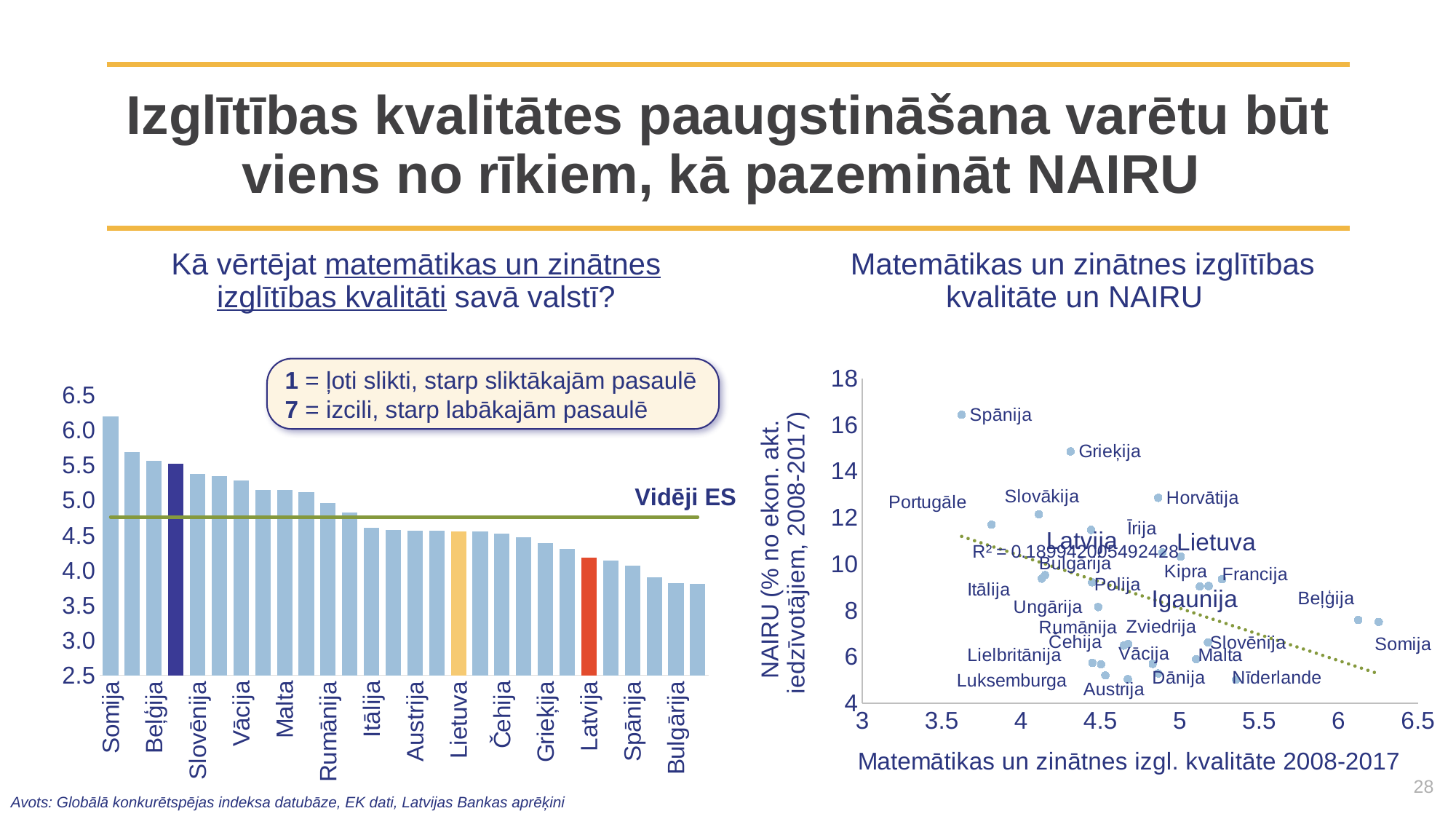
In the left bar chart, is the value for Somija greater or less than 6? greater In the left bar chart, do the values rise or fall from left to right? fall In the right scatter chart, which country has the highest NAIRU? Spānija In the left bar chart, what colour is the bar for Latvija? red In the right scatter chart, is the NAIRU value for Grieķija greater or less than 14? greater In the left bar chart, is the value for Beļģija greater or less than 5? greater In the left bar chart, which country has the highest rating? Somija In the left bar chart, which is larger, the value for Vācija or the value for Spānija? Vācija What kind of chart is the right chart, 'Matemātikas un zinātnes izglītības kvalitāte un NAIRU'? scatter chart What kind of chart is the left chart, 'Kā vērtējat matemātikas un zinātnes izglītības kvalitāti savā valstī?'? bar chart